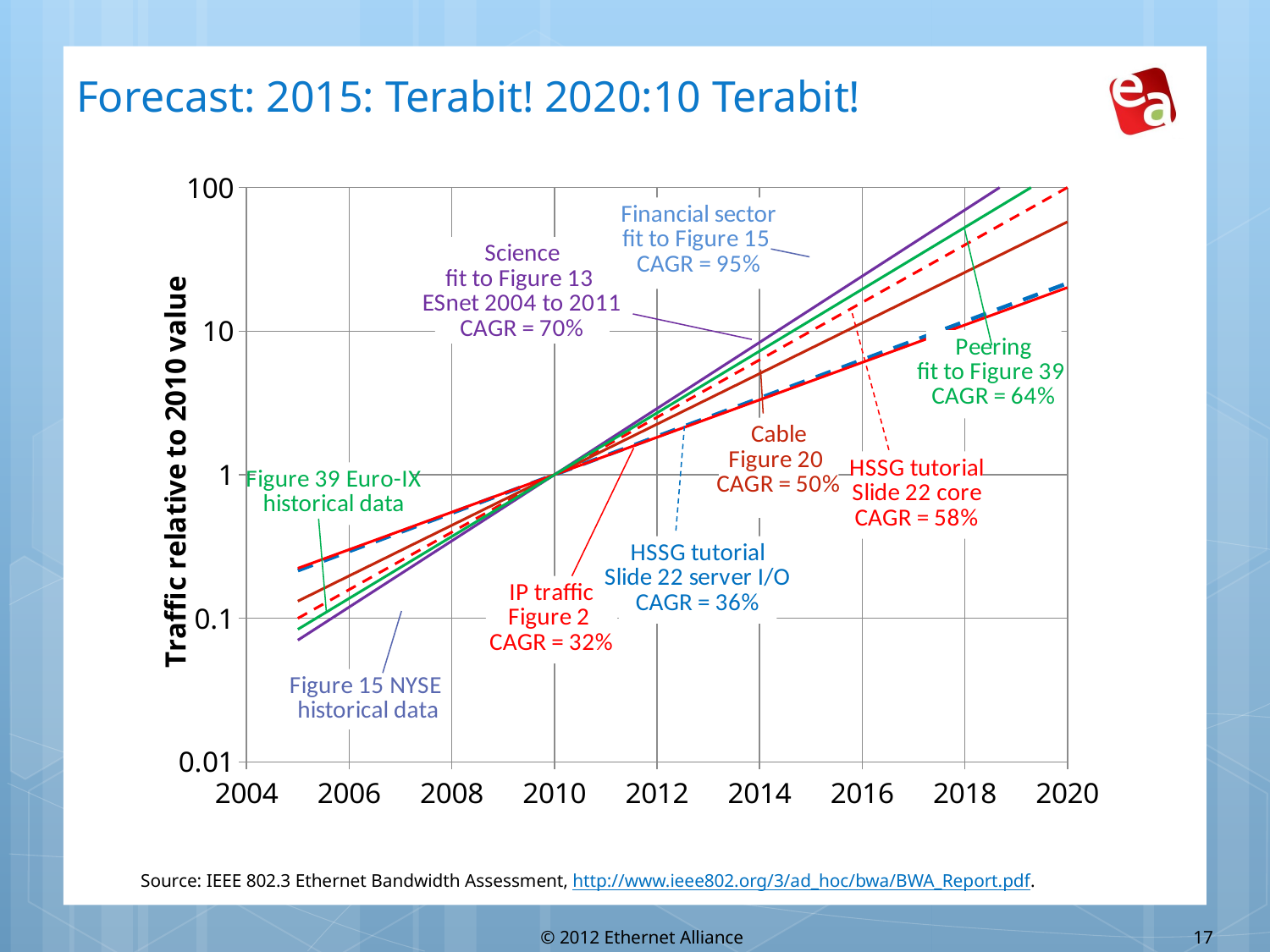
What is the label of the y axis? Traffic relative to 2010 value Which line has the lowest CAGR shown on the chart? IP traffic Figure 2 Which has the higher CAGR, the Science fit to Figure 13 or the Peering fit to Figure 39? Science fit to Figure 13 What kind of chart is shown on the slide? line chart Is the value of the Cable Figure 20 line in 2014 greater or less than 10? less Which line has the highest CAGR shown on the chart? Financial sector fit to Figure 15 Do the lines rise or fall as the year increases along the x axis? rise What CAGR is given for the HSSG tutorial Slide 22 server I/O line? 36% What CAGR is given for the Financial sector fit to Figure 15? 95% What is the difference in percentage points between the Financial sector CAGR and the IP traffic CAGR? 63 What CAGR is given for the Cable Figure 20 line? 50% What CAGR is given for the Science fit to Figure 13 (ESnet 2004 to 2011)? 70%